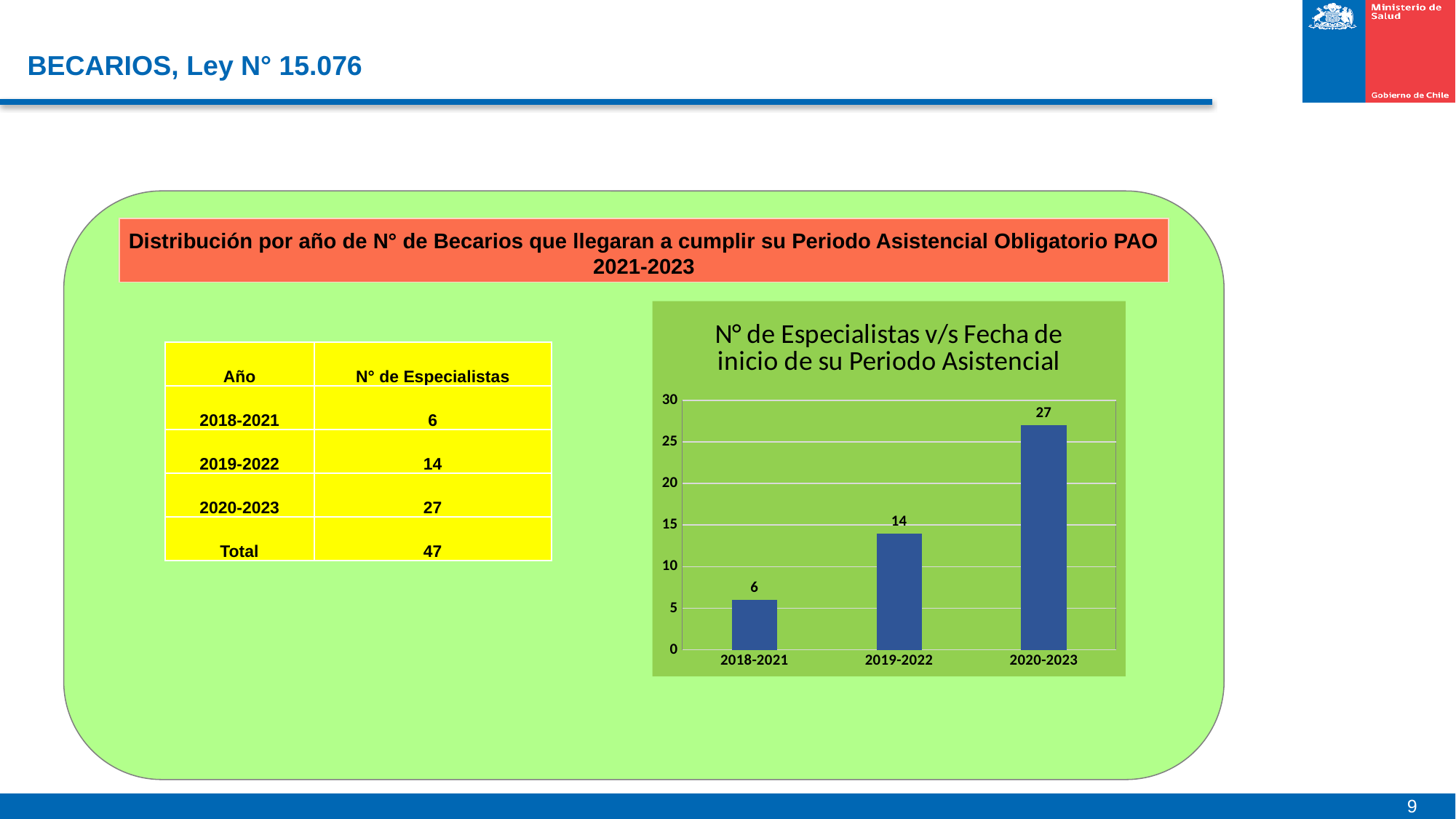
Is the value for 2020-2023 greater or less than 25? greater What kind of chart is shown on the slide? bar chart What is the value for 2018-2021 in the chart? 6 Which period has the lowest number of specialists in the chart? 2018-2021 What is the value for 2020-2023 in the chart? 27 What is the difference between the values for 2019-2022 and 2018-2021? 8 Do the values rise or fall from 2018-2021 to 2020-2023? rise Which is larger, the value for 2019-2022 or the value for 2018-2021? 2019-2022 What is the value for 2019-2022 in the chart? 14 Which period has the highest number of specialists in the chart? 2020-2023 What is the difference between the values for 2020-2023 and 2019-2022? 13 How many periods are shown on the x axis of the chart? 3